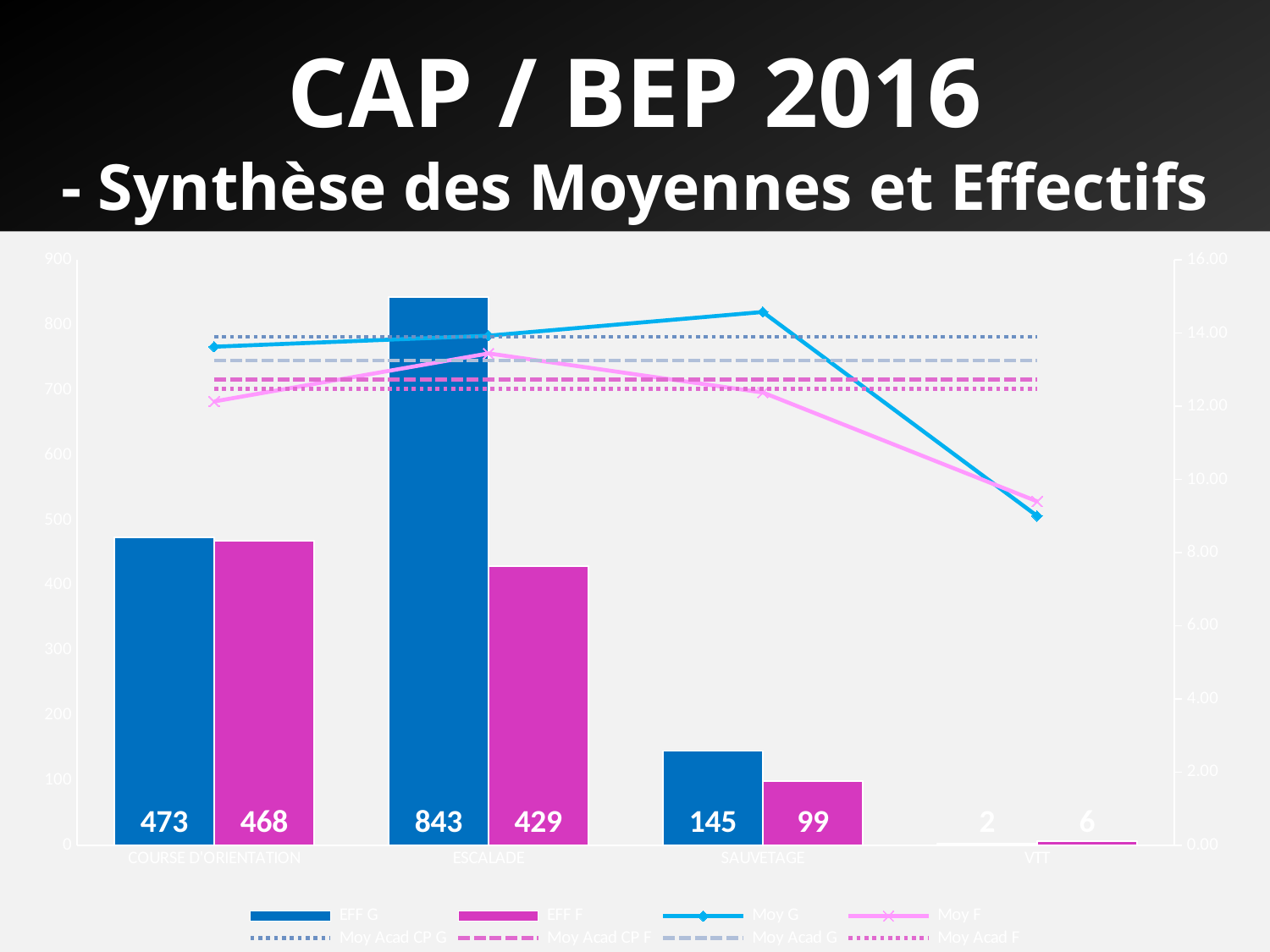
Which category has the lowest EFF F value? VTT How many series does the legend list? 8 What is the difference between EFF G and EFF F for ESCALADE? 414 What is the EFF F value for SAUVETAGE? 99 What is the combined total of EFF G and EFF F for SAUVETAGE? 244 What is the EFF G value for VTT? 2 Which category has the highest EFF G value? ESCALADE Is the Moy G value for VTT greater or less than 10.00? less What is the EFF G value for ESCALADE? 843 How many categories are shown on the x axis? 4 Does the Moy G line rise or fall from SAUVETAGE to VTT? fall For COURSE D'ORIENTATION, which is larger, EFF G or EFF F? EFF G